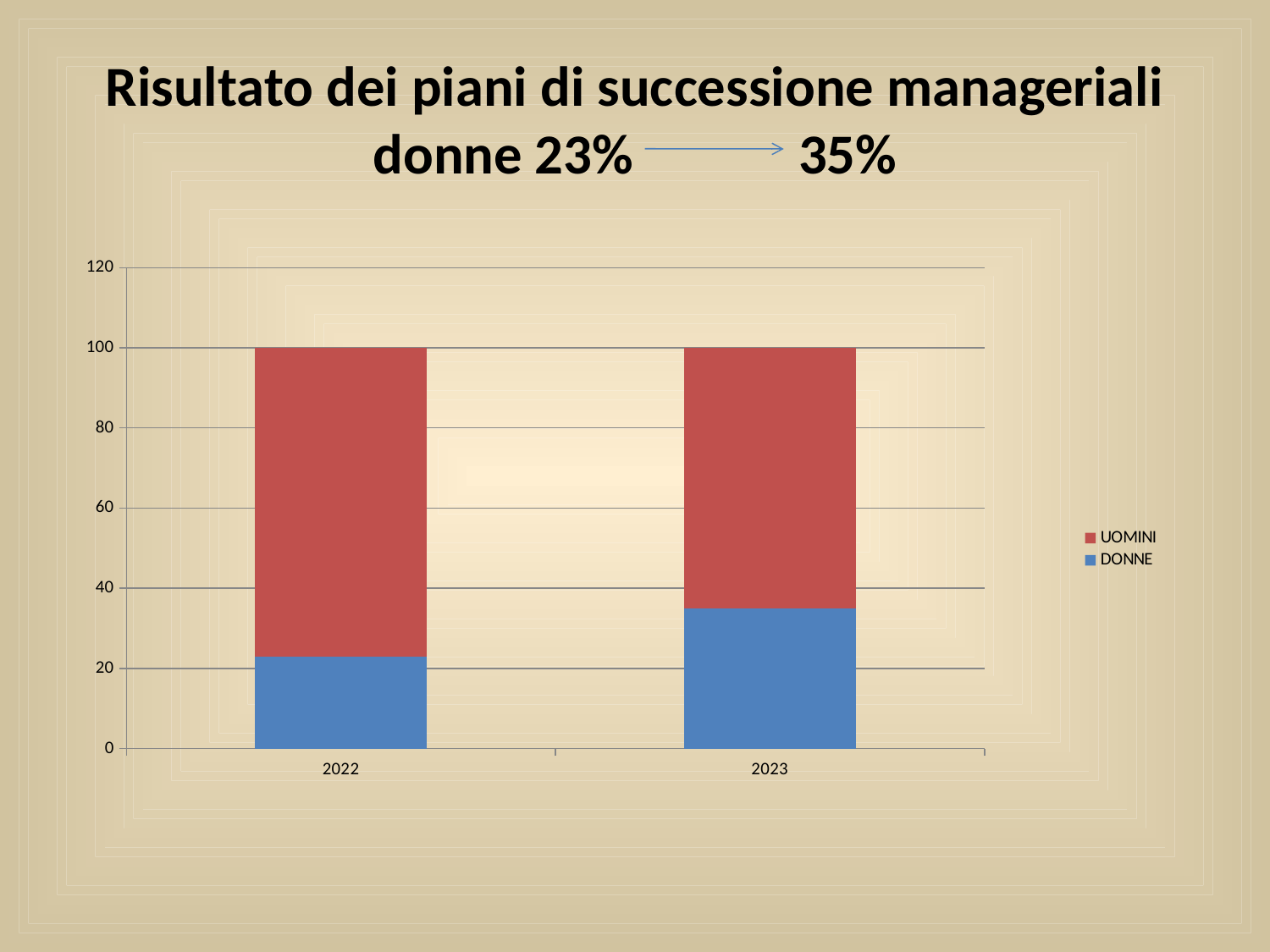
How many series does the chart legend list? 2 Is the UOMINI value for 2023 greater or less than 60? greater What kind of chart is shown on the slide? stacked bar chart In which year is the UOMINI value lowest? 2023 Is the DONNE value for 2022 greater or less than 40? less What are the two series named in the chart legend? UOMINI and DONNE Is the DONNE value for 2023 greater or less than 20? greater Does the DONNE value rise or fall from 2022 to 2023? rise What is the total height of the stacked bar for 2022? 100 How many years are shown on the x axis of the chart? 2 Which year has the larger DONNE value, 2022 or 2023? 2023 What is the total height of the stacked bar for 2023? 100